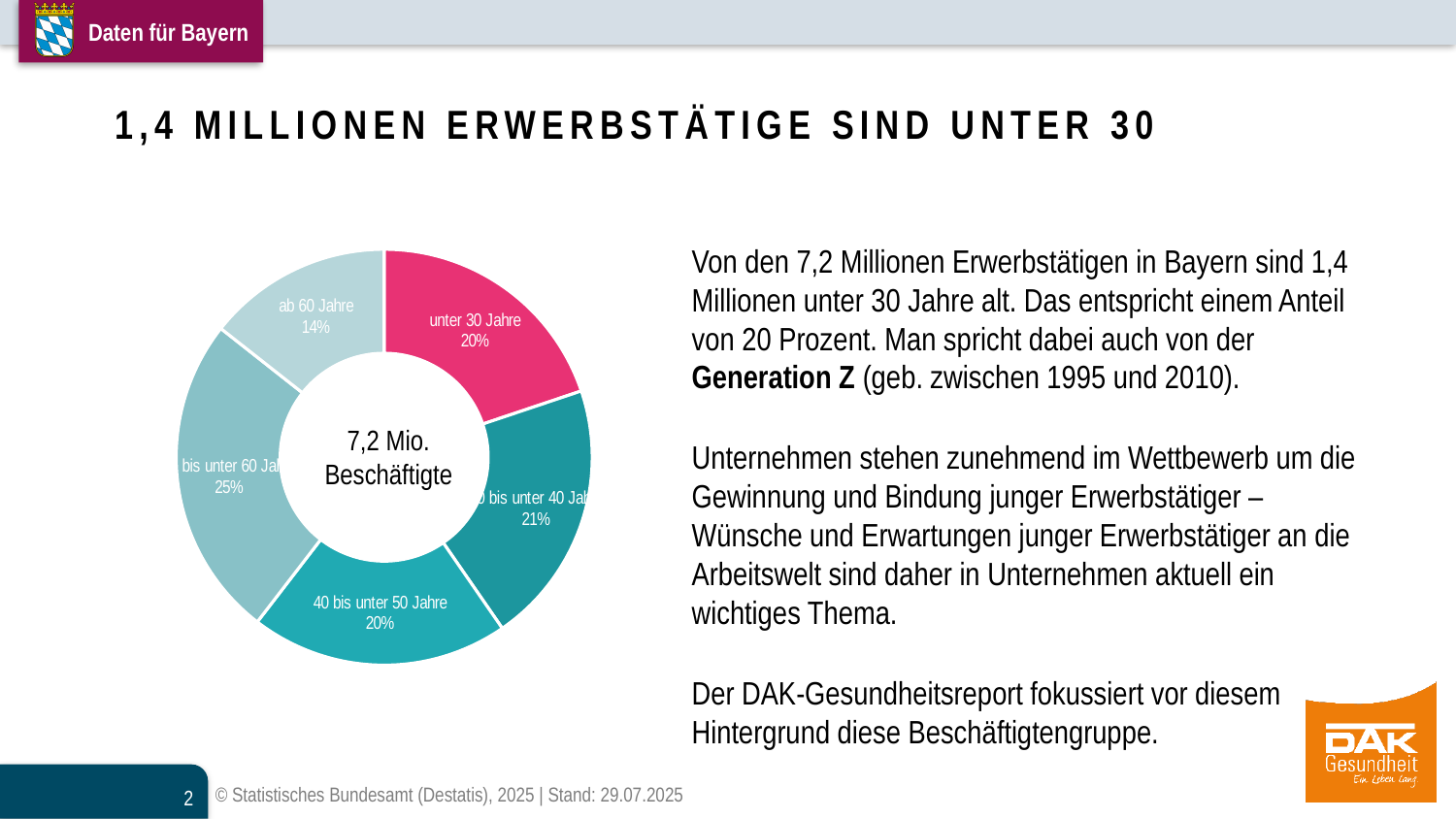
What is the difference in percentage points between the "unter 30 Jahre" share and the "ab 60 Jahre" share? 6 percentage points What share of the chart is labelled "unter 30 Jahre"? 20% What colour is the "unter 30 Jahre" segment of the chart? Pink/magenta How many segments does the donut chart have? 5 What text is shown in the centre of the donut chart? 7,2 Mio. Beschäftigte Which age group has the smallest share in the chart? ab 60 Jahre Which age group has the largest share in the chart? 50 bis unter 60 Jahre (25%) Which is larger: the share for "unter 30 Jahre" or the share for "ab 60 Jahre"? unter 30 Jahre What percentage is shown for the "30 bis unter 40 Jahre" segment? 21% What kind of chart is shown on the slide? Pie (donut) chart What share of the chart is labelled "40 bis unter 50 Jahre"? 20% What share of the chart is labelled "ab 60 Jahre"? 14%